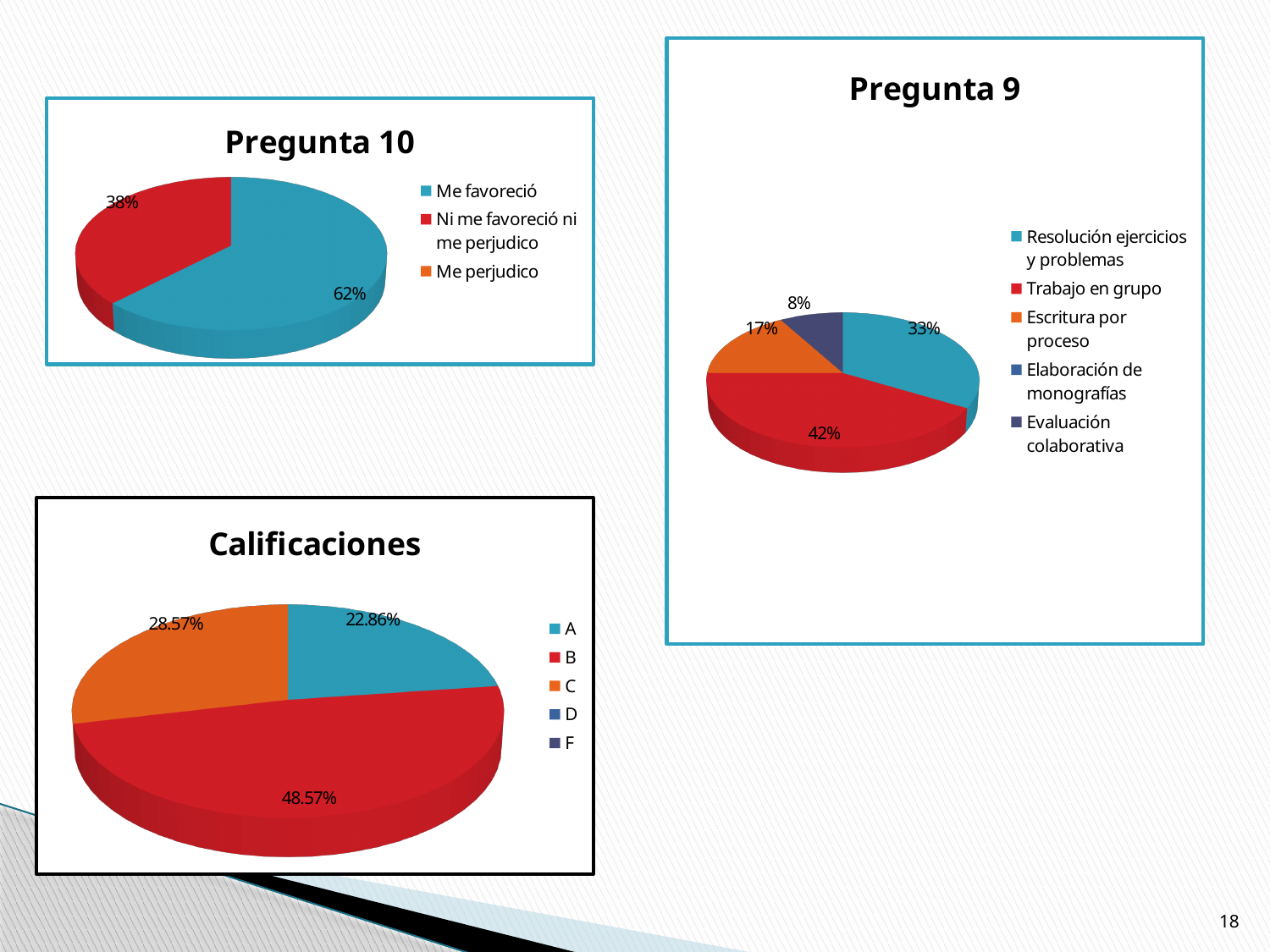
In the Pregunta 10 chart, what percentage is shown for 'Ni me favoreció ni me perjudico'? 38% In the Pregunta 9 chart, which category has the largest share? Trabajo en grupo In the Calificaciones chart, which is larger, the share for A or the share for C? C In the Pregunta 9 chart, what percentage is shown for 'Resolución ejercicios y problemas'? 33% In the Pregunta 10 chart, what percentage is shown for 'Me favoreció'? 62% In the Pregunta 10 chart, what is the difference in percentage points between 'Me favoreció' and 'Ni me favoreció ni me perjudico'? 24 In the Pregunta 9 chart, what percentage is shown for 'Escritura por proceso'? 17% In the Pregunta 10 chart, which category has the largest slice? Me favoreció In the Calificaciones chart, what percentage is shown for grade B? 48.57% What type of chart is the Calificaciones chart? Pie chart In the Pregunta 9 chart, what percentage is shown for 'Trabajo en grupo'? 42% How many entries does the legend of the Pregunta 10 chart list? 3